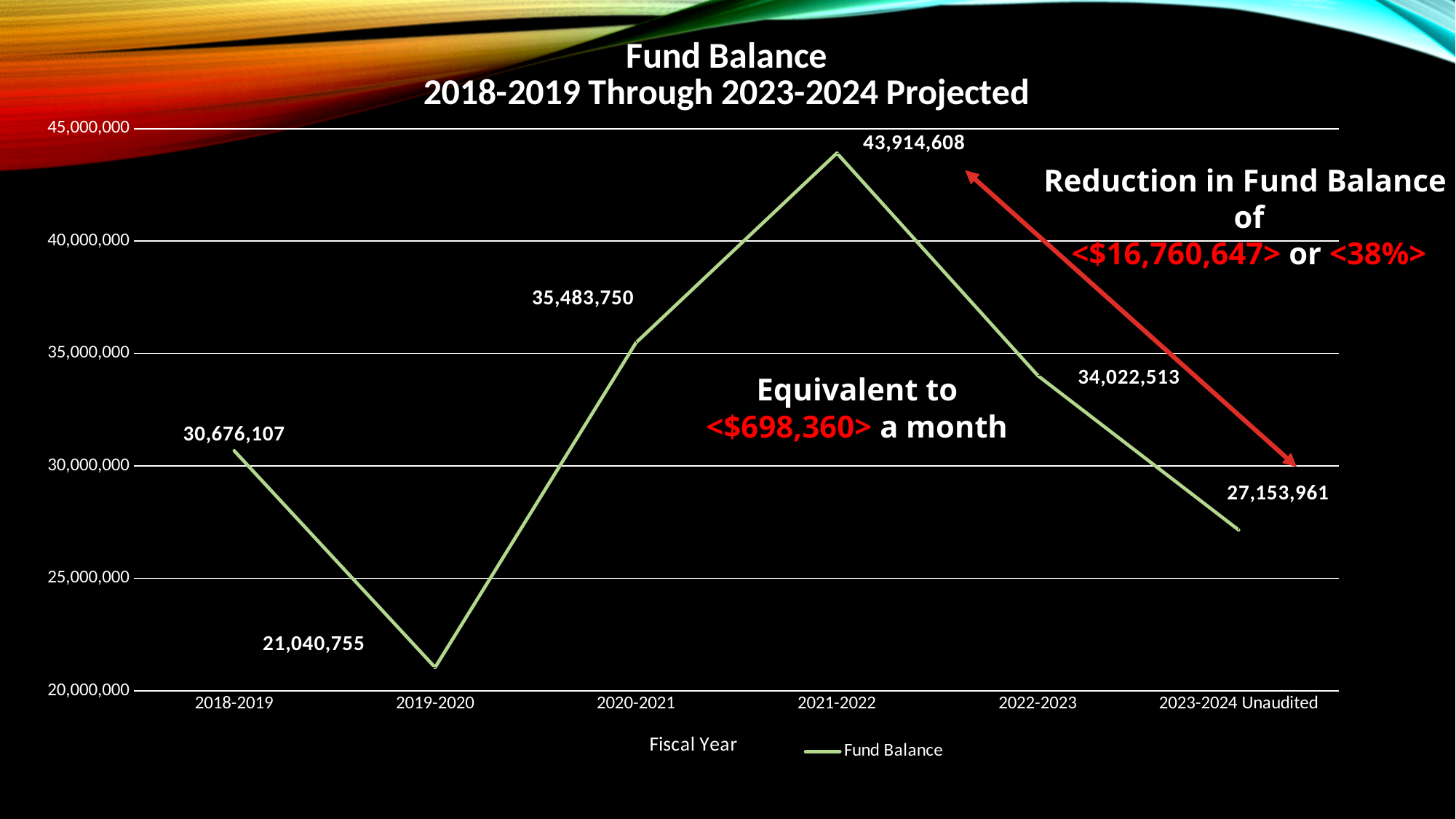
Which fiscal year has the lowest fund balance? 2019-2020 How many fiscal years are plotted on the chart? 6 What is the fund balance for 2021-2022? 43,914,608 Does the fund balance rise or fall from 2021-2022 to 2023-2024 Unaudited? fall What is the fund balance for 2023-2024 Unaudited? 27,153,961 Which is larger, the fund balance for 2020-2021 or for 2022-2023? 2020-2021 Is the fund balance for 2022-2023 greater or less than 35,000,000? less What is the difference between the fund balance in 2021-2022 and in 2022-2023? 9,892,095 What is the fund balance for 2019-2020? 21,040,755 What kind of chart is shown on the slide? line chart What is the fund balance for 2018-2019? 30,676,107 Which fiscal year has the highest fund balance? 2021-2022